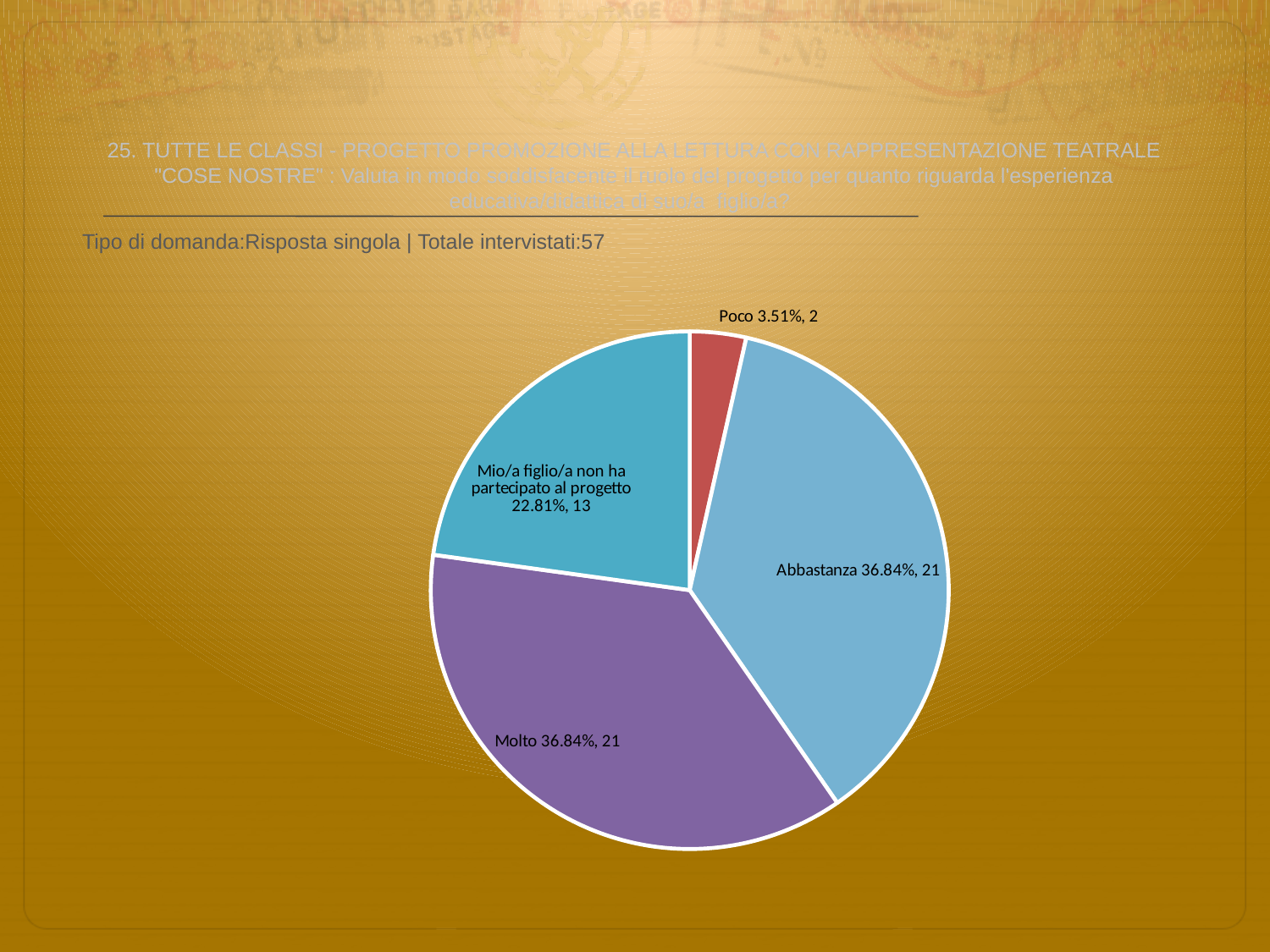
What colour is the "Molto" slice of the pie? purple Which is larger, the "Abbastanza" slice or the "Mio/a figlio/a non ha partecipato al progetto" slice? Abbastanza What is the difference in number of respondents between "Abbastanza" and "Mio/a figlio/a non ha partecipato al progetto"? 8 How many respondents answered "Mio/a figlio/a non ha partecipato al progetto"? 13 Which category has the smallest slice of the pie? Poco What is the difference in number of respondents between "Molto" and "Poco"? 19 What kind of chart is shown on the slide? pie chart How many respondents chose "Abbastanza"? 21 What percentage of the pie does the "Mio/a figlio/a non ha partecipato al progetto" slice represent? 22.81% How many respondents chose "Molto"? 21 What percentage of the pie does the "Poco" slice represent? 3.51% How many slices does the pie chart have? 4